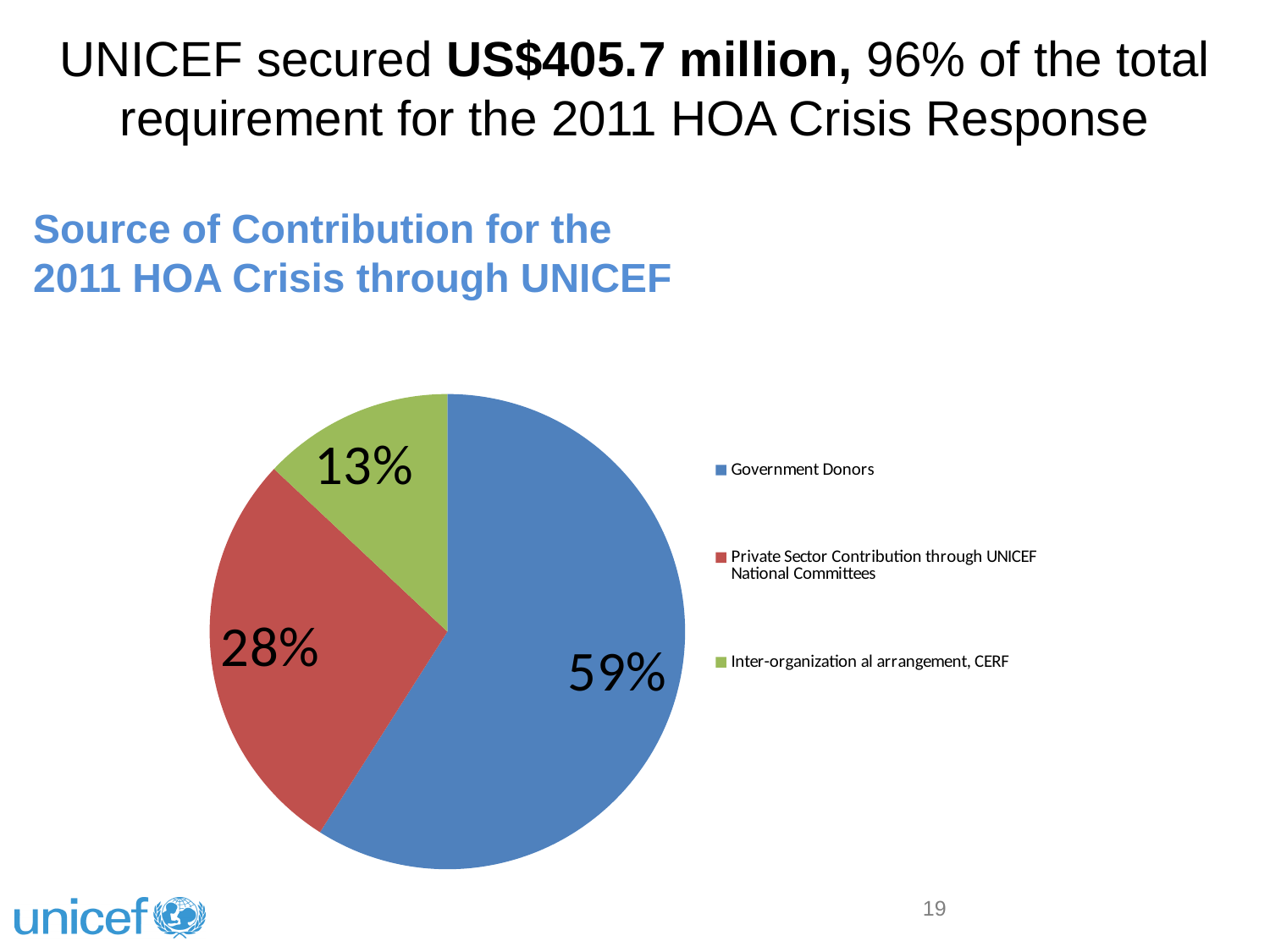
Which source of contribution has the largest share of the pie? Government Donors Which is larger: the share for Private Sector Contribution through UNICEF National Committees or the share for Inter-organization al arrangement, CERF? Private Sector Contribution through UNICEF National Committees What is the title of the chart? Source of Contribution for the 2011 HOA Crisis through UNICEF What colour is the Government Donors slice in the pie chart? blue What is the difference in percentage points between the Government Donors share and the Private Sector Contribution through UNICEF National Committees share? 31 What share of the pie is Inter-organization al arrangement, CERF? 13% What share of the pie is Government Donors? 59% What kind of chart is shown on the slide? pie chart Which source of contribution has the smallest share of the pie? Inter-organization al arrangement, CERF What is the difference in percentage points between the Private Sector Contribution through UNICEF National Committees share and the Inter-organization al arrangement, CERF share? 15 What share of the pie is Private Sector Contribution through UNICEF National Committees? 28% How many slices does the pie chart have? 3